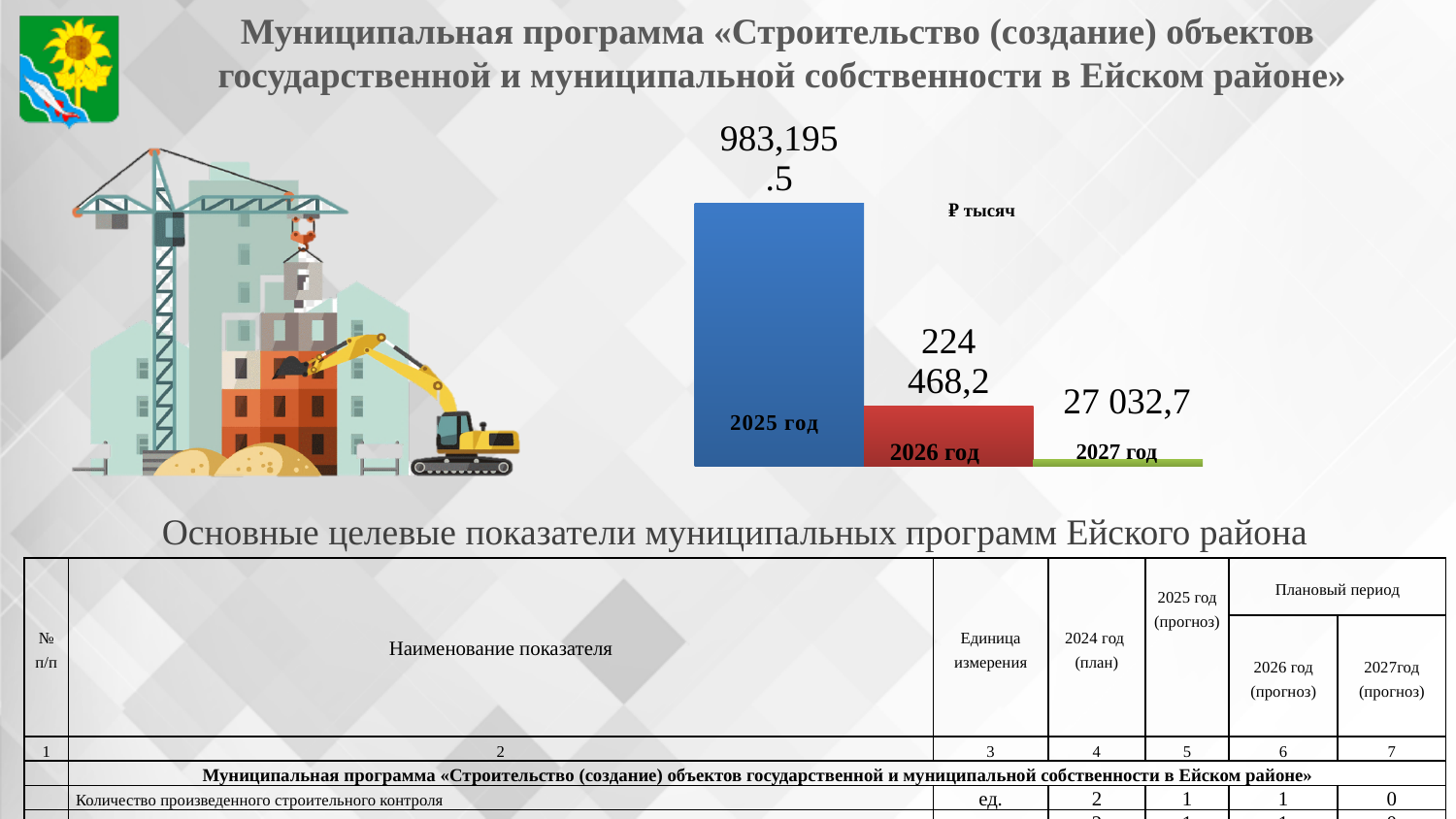
Which year has the lowest value in the bar chart? 2027 год What unit is indicated next to the bar chart? ₽ тысяч How many bars are shown in the chart? 3 Which year has the highest value in the bar chart? 2025 год What kind of chart is shown on the slide? bar chart What is the value shown for 2025 год in the bar chart? 983,195.5 What colour is the bar for 2026 год in the chart? red What is the value shown for 2027 год in the bar chart? 27 032,7 Which is larger in the bar chart, the value for 2026 год or the value for 2027 год? 2026 год What is the value shown for 2026 год in the bar chart? 224 468,2 Do the values in the bar chart rise or fall from 2025 год to 2027 год? fall What is the difference between the values for 2026 год and 2027 год in the bar chart? 197 435,5